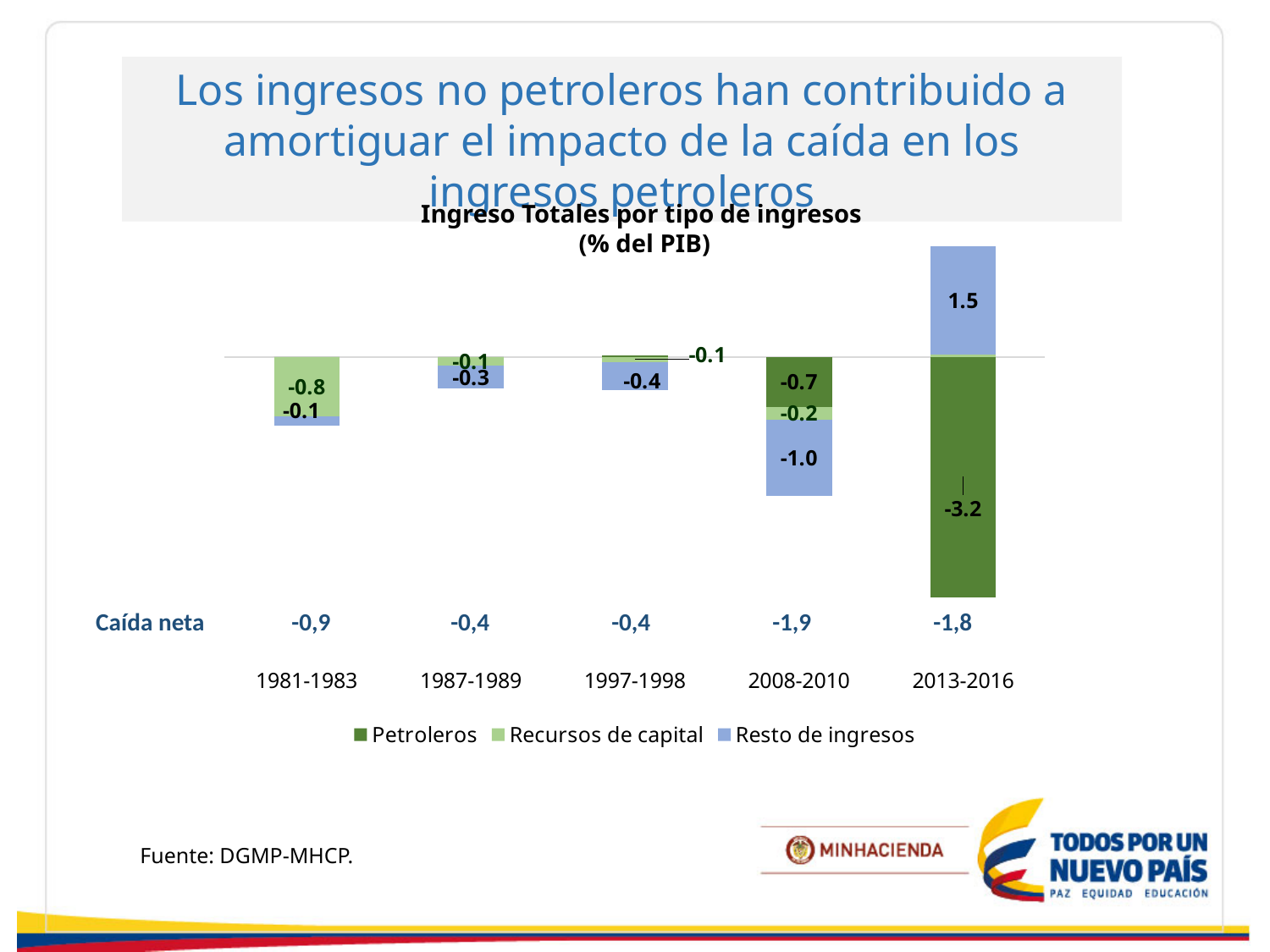
What is the difference between the Petroleros value in 2008-2010 (-0.7) and in 2013-2016 (-3.2)? 2.5 How many series does the legend of the chart list? 3 What is the value for Recursos de capital in 1981-1983? -0.8 How many periods are shown along the x axis of the chart? 5 In which period is the Petroleros value lowest? 2013-2016 What is the value for Petroleros in 2013-2016? -3.2 What kind of chart is shown on the slide? Stacked bar chart What is the value for Petroleros in 2008-2010? -0.7 Which series is shown in dark green in the chart's legend? Petroleros What is the value for Resto de ingresos in 2008-2010? -1.0 What is the value for Resto de ingresos in 2013-2016? 1.5 What is the Caída neta shown for 2008-2010? -1,9